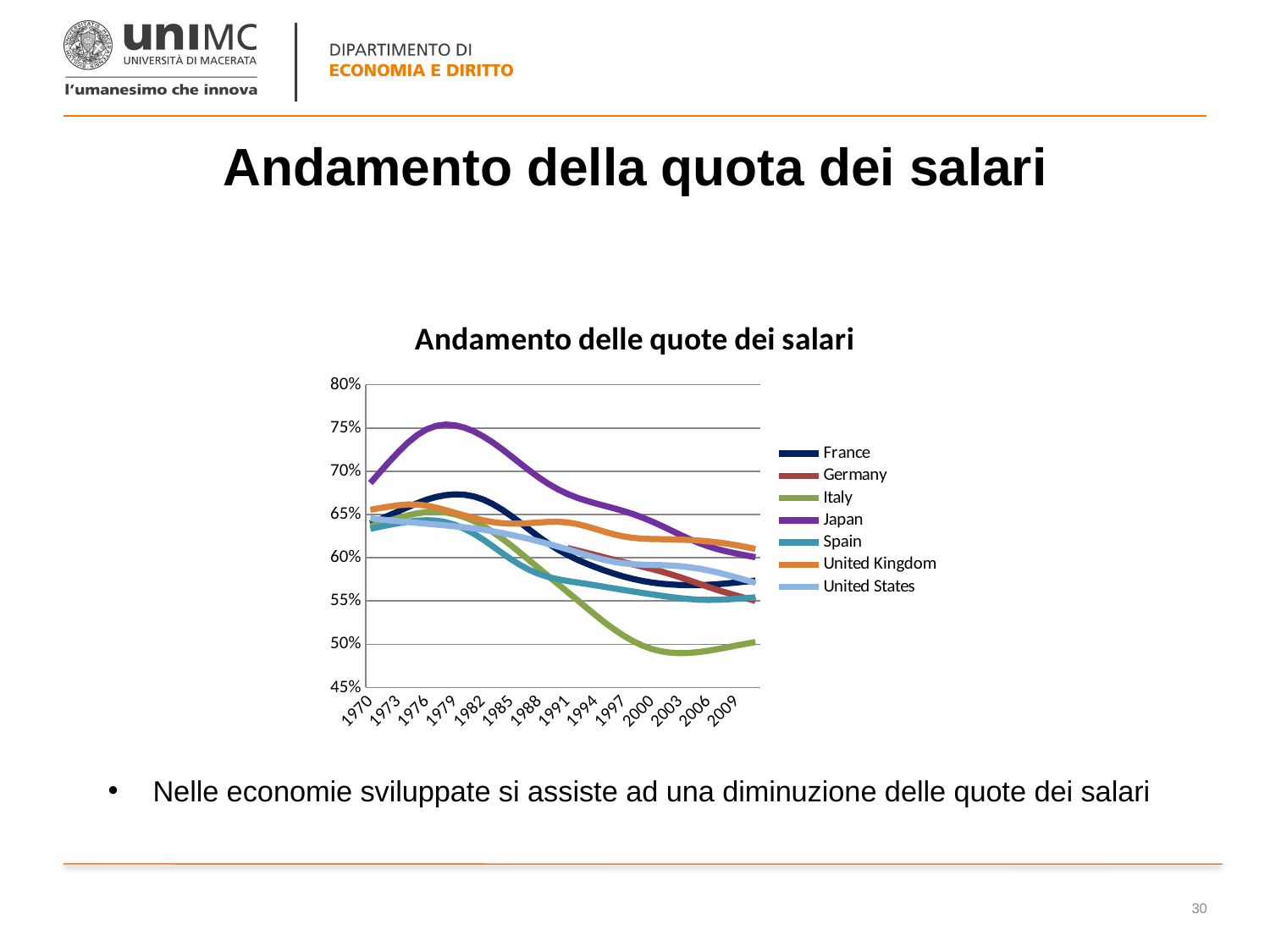
Is the value for Spain in 2009 greater or less than 60%? less How many series does the legend list? 7 Which series is the highest in 1970? Japan Is the value for Italy in 2003 greater or less than 50%? less How many year labels are shown on the x axis? 14 What is the highest value shown on the y axis? 80% What kind of chart is shown on the slide? Line chart Which is larger in 2000, the value for Japan or the value for Italy? Japan Which series is the lowest in 2009? Italy What is the title of the chart? Andamento delle quote dei salari Is the value for Japan in 1979 greater or less than 70%? greater Does the value for Italy rise or fall from 1979 to 2003? Fall